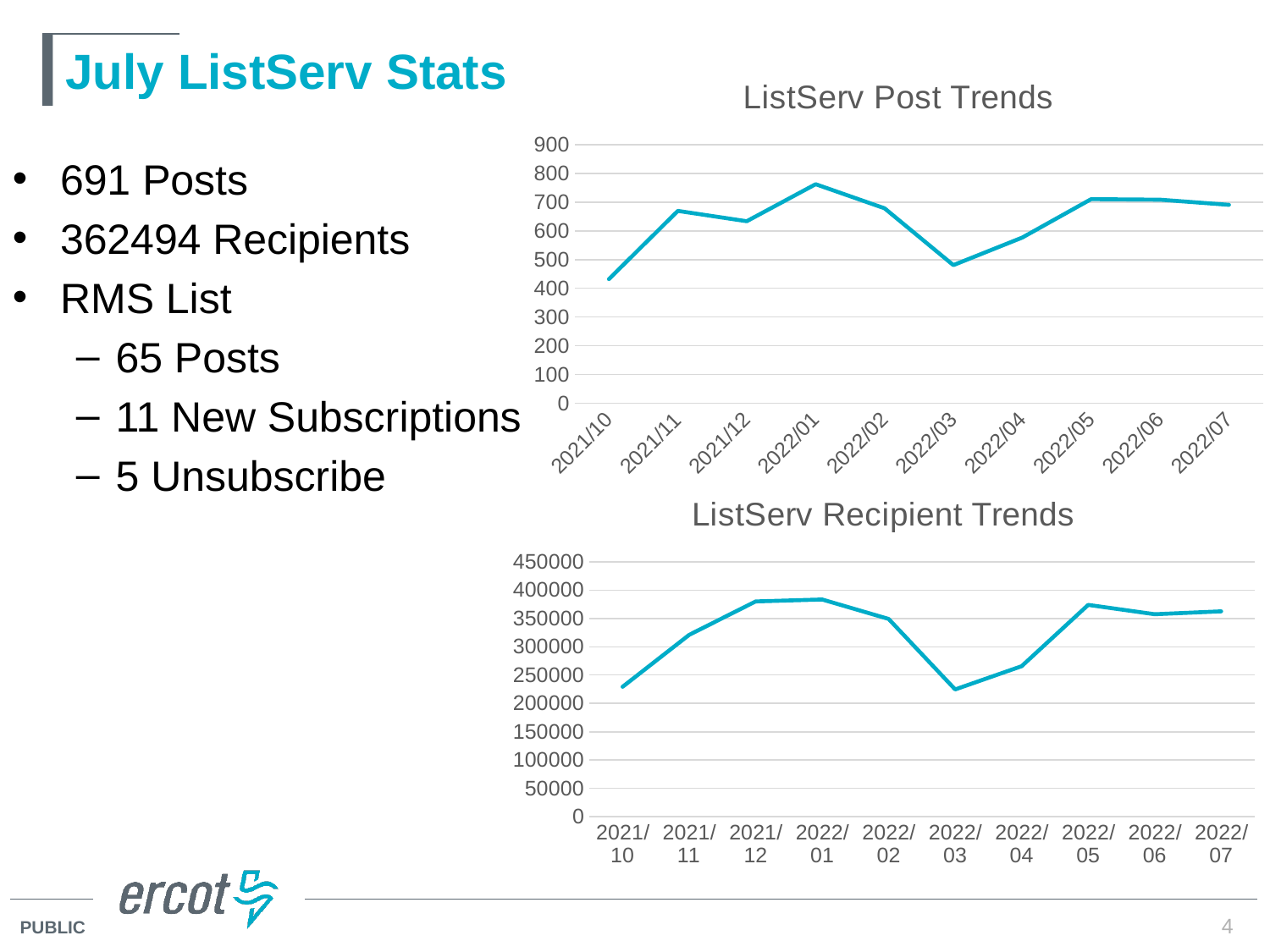
What kind of chart is the ListServ Post Trends chart? line chart On the ListServ Post Trends chart, which is larger, the value for 2022/01 or the value for 2022/03? 2022/01 How many months are plotted on the ListServ Post Trends chart? 10 On the ListServ Post Trends chart, do the values rise or fall from 2021/10 to 2022/01? rise On the ListServ Post Trends chart, is the value for 2021/10 greater or less than 500? less On the ListServ Recipient Trends chart, is the value for 2022/01 greater or less than 350000? greater On the ListServ Post Trends chart, is the value for 2022/01 greater or less than 700? greater On the ListServ Post Trends chart, which month has the highest number of posts? 2022/01 How many months are plotted on the ListServ Recipient Trends chart? 10 On the ListServ Post Trends chart, which month has the lowest number of posts? 2021/10 On the ListServ Recipient Trends chart, do the values rise or fall from 2022/01 to 2022/03? fall